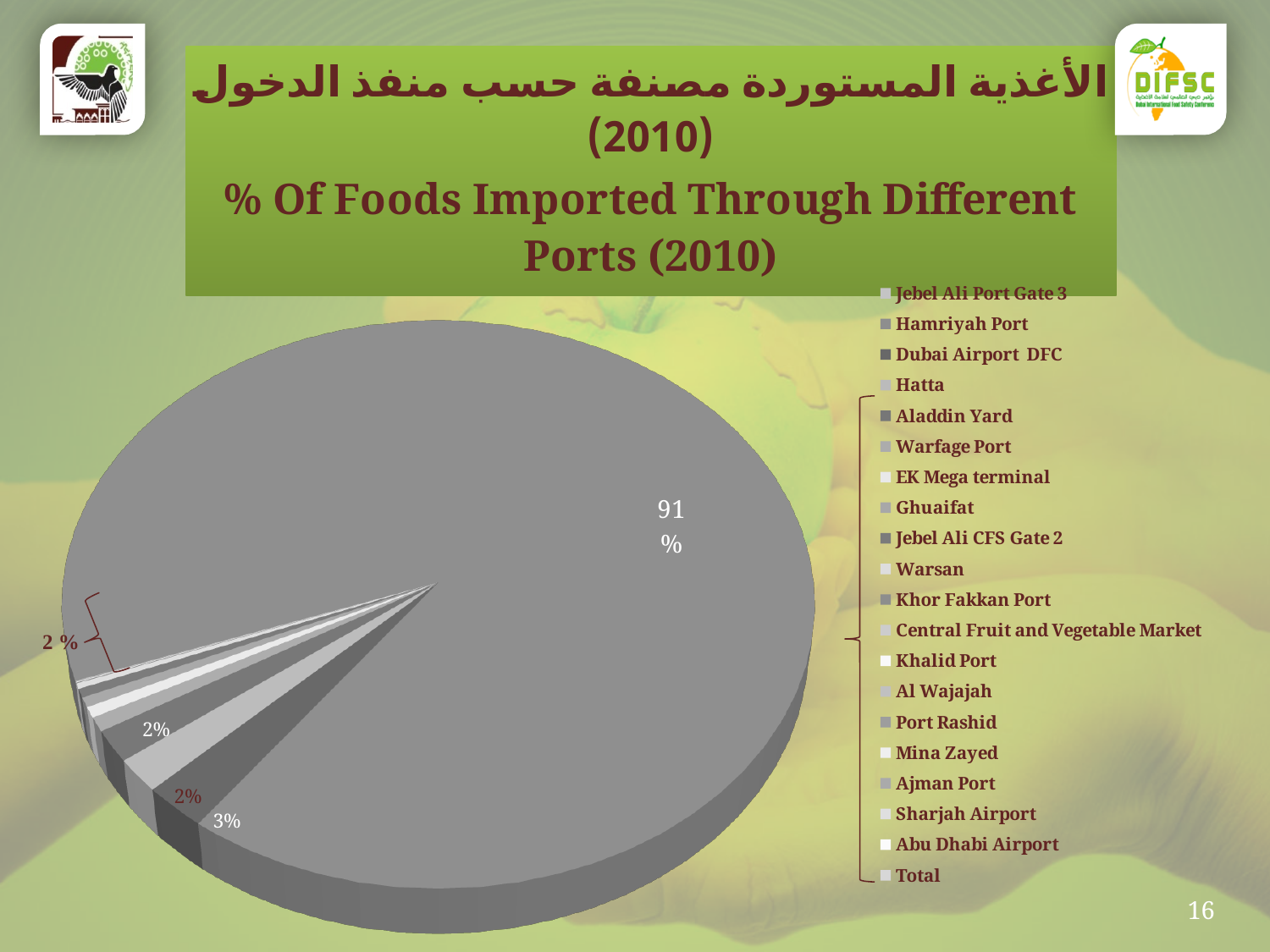
Is the largest slice of the pie chart greater or less than 50%? greater How many entries does the legend of the pie chart list? 20 What percentage is printed on the second-largest labelled slice of the pie chart? 3% What is the first entry listed in the chart's legend? Jebel Ali Port Gate 3 What is the English title of the chart on the slide? % Of Foods Imported Through Different Ports (2010) What is the largest percentage shown on any slice of the pie chart? 91% Which is larger, the slice labelled 91% or the slice labelled 3%? the slice labelled 91% What share of the pie does the largest slice represent? 91% What percentage label is shown with a bracket grouping the smallest slices on the left of the pie? 2 % What percentage is printed on the largest slice of the pie chart? 91% What is the difference between the largest slice (91%) and the slice labelled 3%? 88% What kind of chart is shown on the slide? pie chart